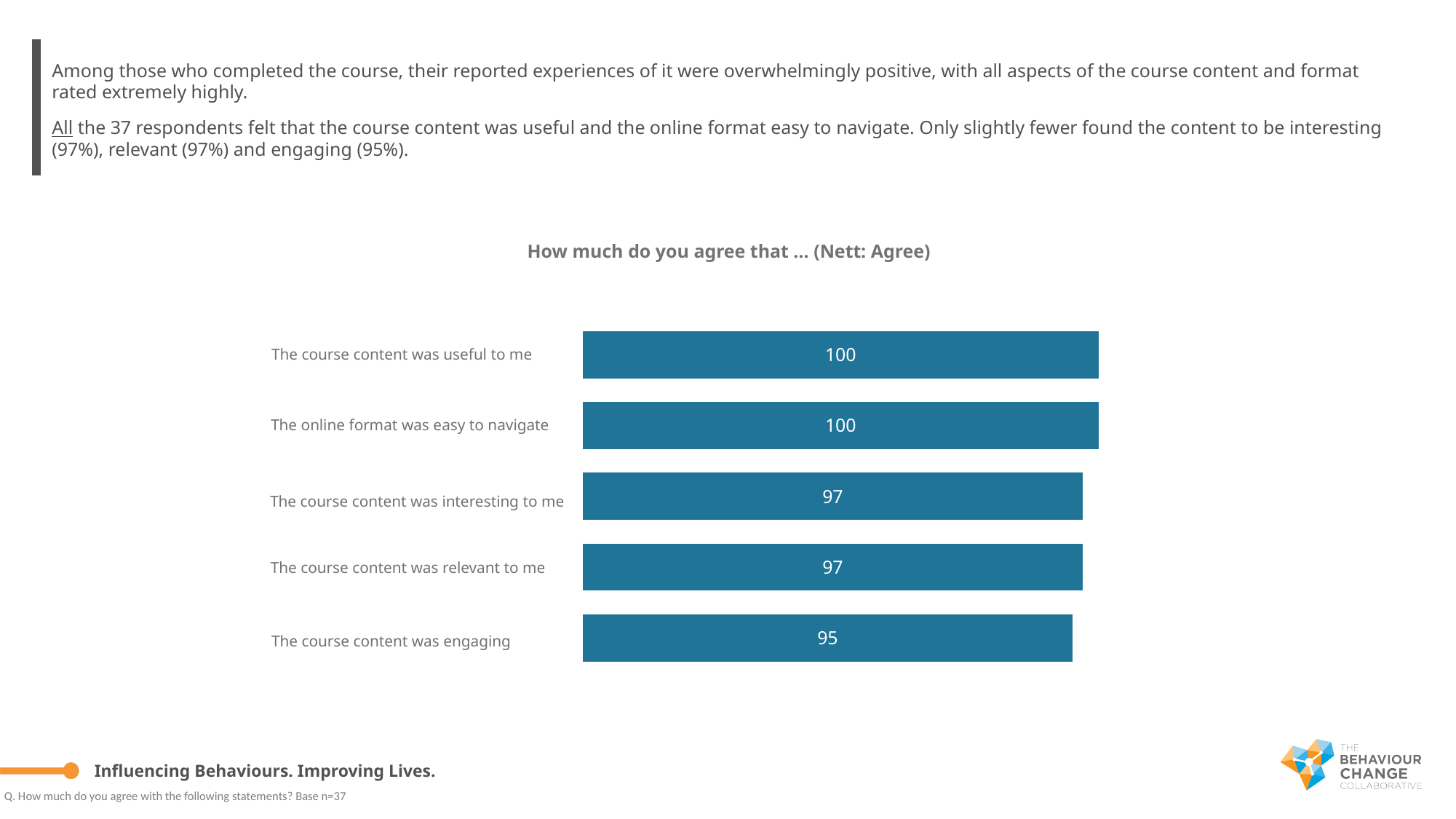
What is the difference between the values for 'The course content was relevant to me' and 'The course content was engaging'? 2 What is the difference between the values for 'The course content was useful to me' and 'The course content was engaging'? 5 What kind of chart is shown on the slide? Bar chart Which statement has the lowest value? The course content was engaging What is the value for 'The online format was easy to navigate'? 100 What is the value for 'The course content was useful to me'? 100 What is the value for 'The course content was interesting to me'? 97 How many statements have a value of 100? 2 How many statements are shown in the chart? 5 What is the title of the chart? How much do you agree that ... (Nett: Agree) What is the value for 'The course content was engaging'? 95 Which is larger: the value for 'The online format was easy to navigate' or 'The course content was relevant to me'? The online format was easy to navigate